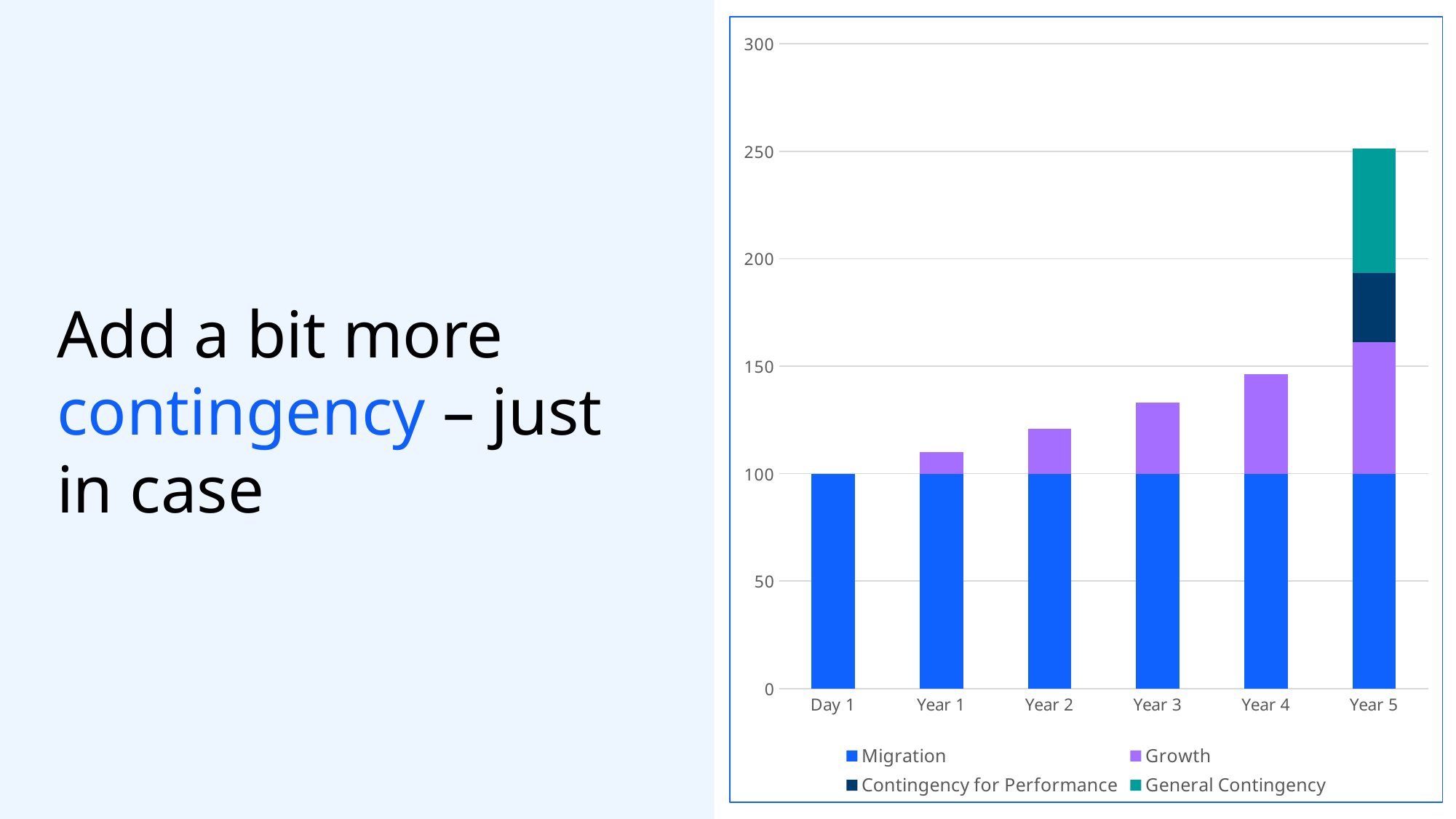
How many series does the chart's legend list? 4 What is the total height of the Day 1 bar? 100 What is the Migration value for Year 3? 100 Is the total value for Year 4 greater or less than 150? less How many categories are shown on the x axis of the chart? 6 Do the total bar heights rise or fall from Day 1 to Year 5? Rise What is the Migration value for Day 1? 100 Which category has the highest total bar? Year 5 Which category has the lowest total bar? Day 1 Is the total value for Year 5 greater or less than 200? greater Which has the larger total bar, Year 2 or Year 4? Year 4 What kind of chart is shown on the slide? Stacked bar chart